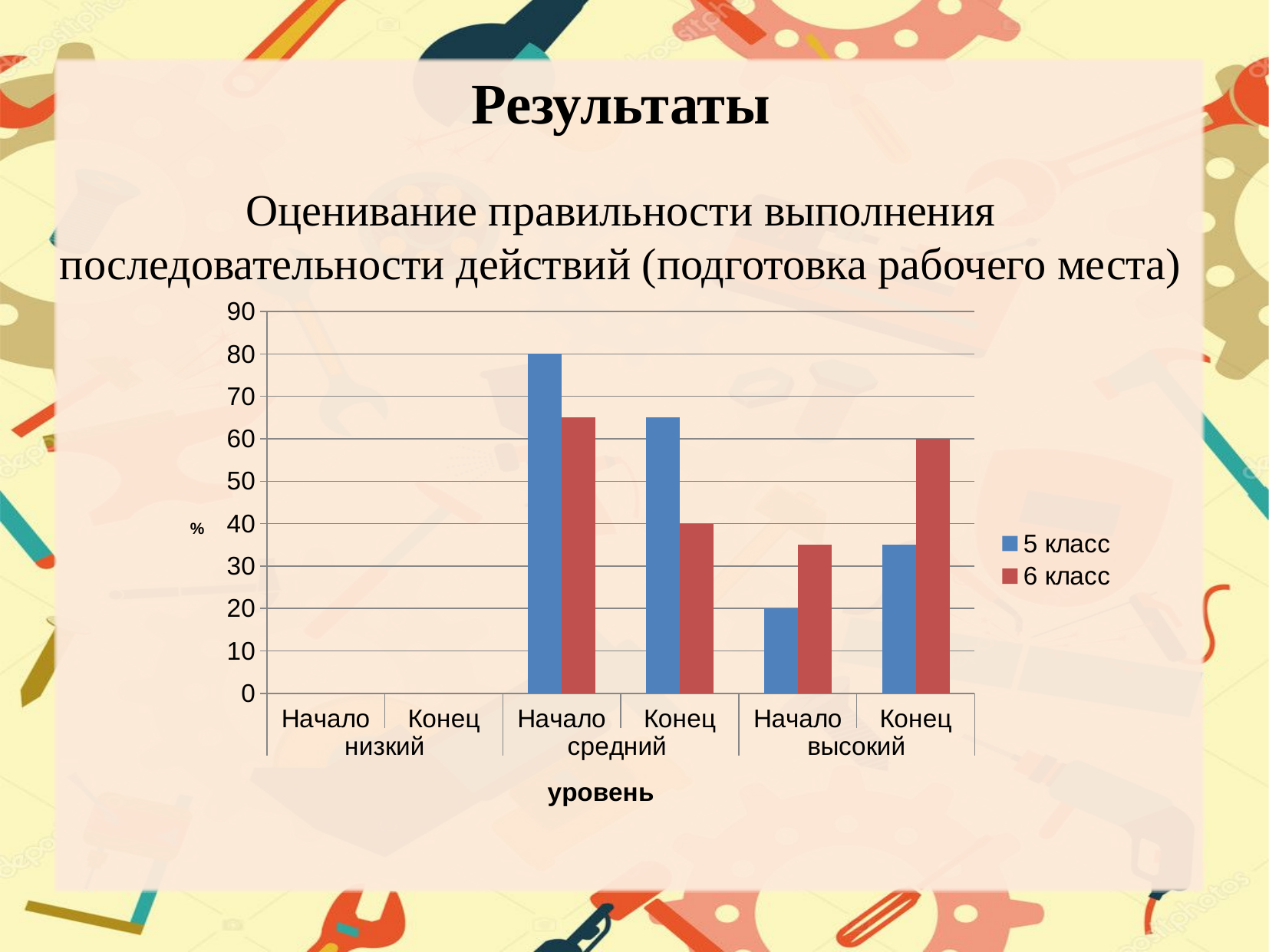
What type of chart is shown on the slide? bar chart What are the two series named in the legend? 5 класс and 6 класс What is the value for 5 класс at Начало of the высокий level? 20 What is the value for 6 класс at Конец of the средний level? 40 Which category has the highest value for 5 класс? Начало средний What is the value for 5 класс at Начало of the средний level? 80 Is the value for 5 класс at Конец of the средний level greater or less than 60? greater At Начало of the средний level, which series has the larger value, 5 класс or 6 класс? 5 класс How many series does the legend list? 2 How many categories are shown along the x axis? 6 What is the value for 6 класс at Конец of the высокий level? 60 Is the value for 6 класс at Начало of the высокий level greater or less than 40? less